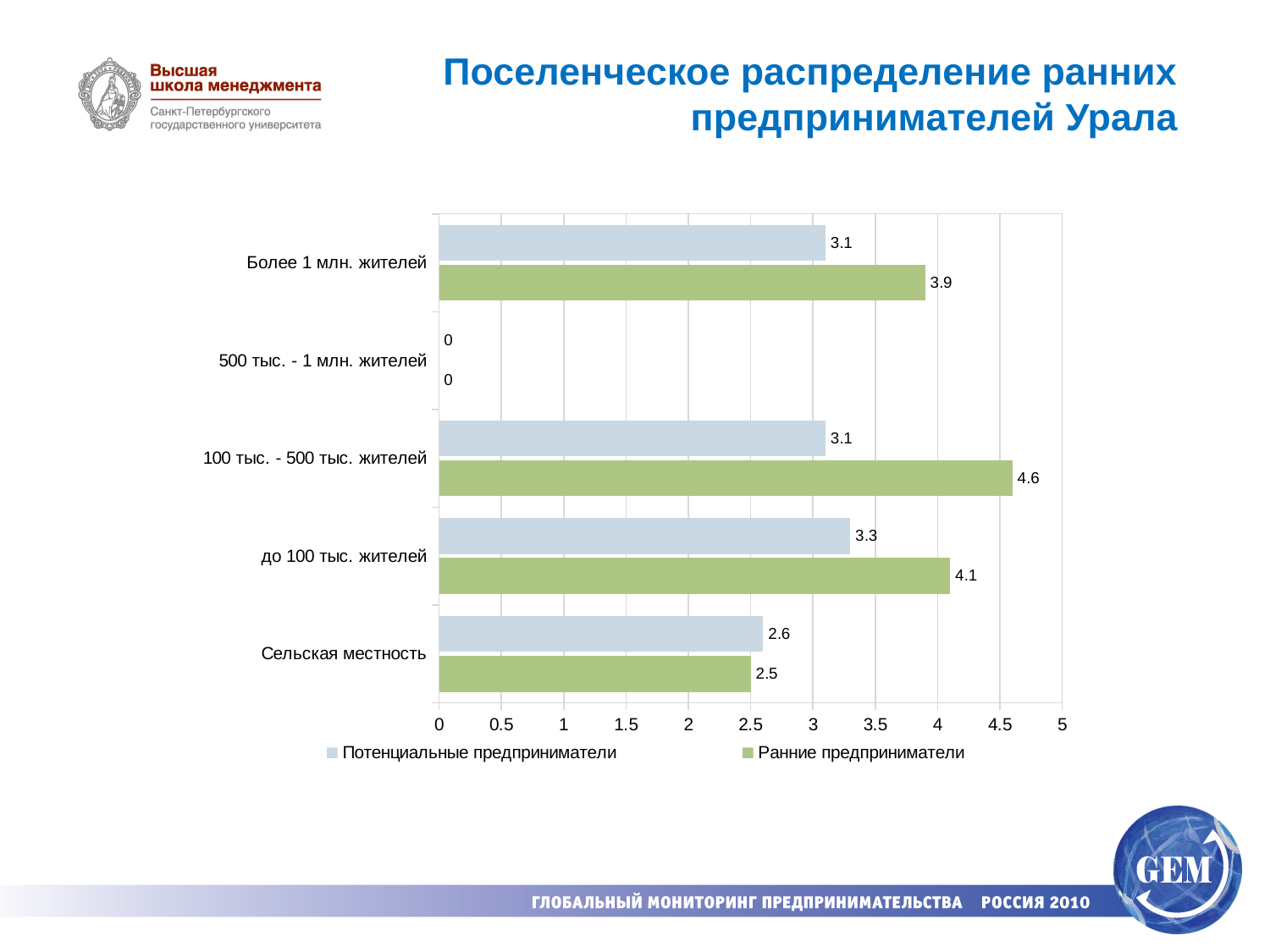
Which category has the lowest non-zero value for Потенциальные предприниматели? Сельская местность How many series does the legend list? 2 What is the value for Ранние предприниматели in the category 100 тыс. - 500 тыс. жителей? 4.6 What kind of chart is shown on the slide? Bar chart What is the difference between Ранние предприниматели and Потенциальные предприниматели in the category до 100 тыс. жителей? 0.8 In the category Сельская местность, which series has the larger value: Потенциальные предприниматели or Ранние предприниматели? Потенциальные предприниматели Which category has the highest value for Ранние предприниматели? 100 тыс. - 500 тыс. жителей How many categories are shown on the chart? 5 What is the value for Ранние предприниматели in the category Более 1 млн. жителей? 3.9 What value is shown for both series in the category 500 тыс. - 1 млн. жителей? 0 What is the title of the slide? Поселенческое распределение ранних предпринимателей Урала What is the value for Потенциальные предприниматели in the category Сельская местность? 2.6